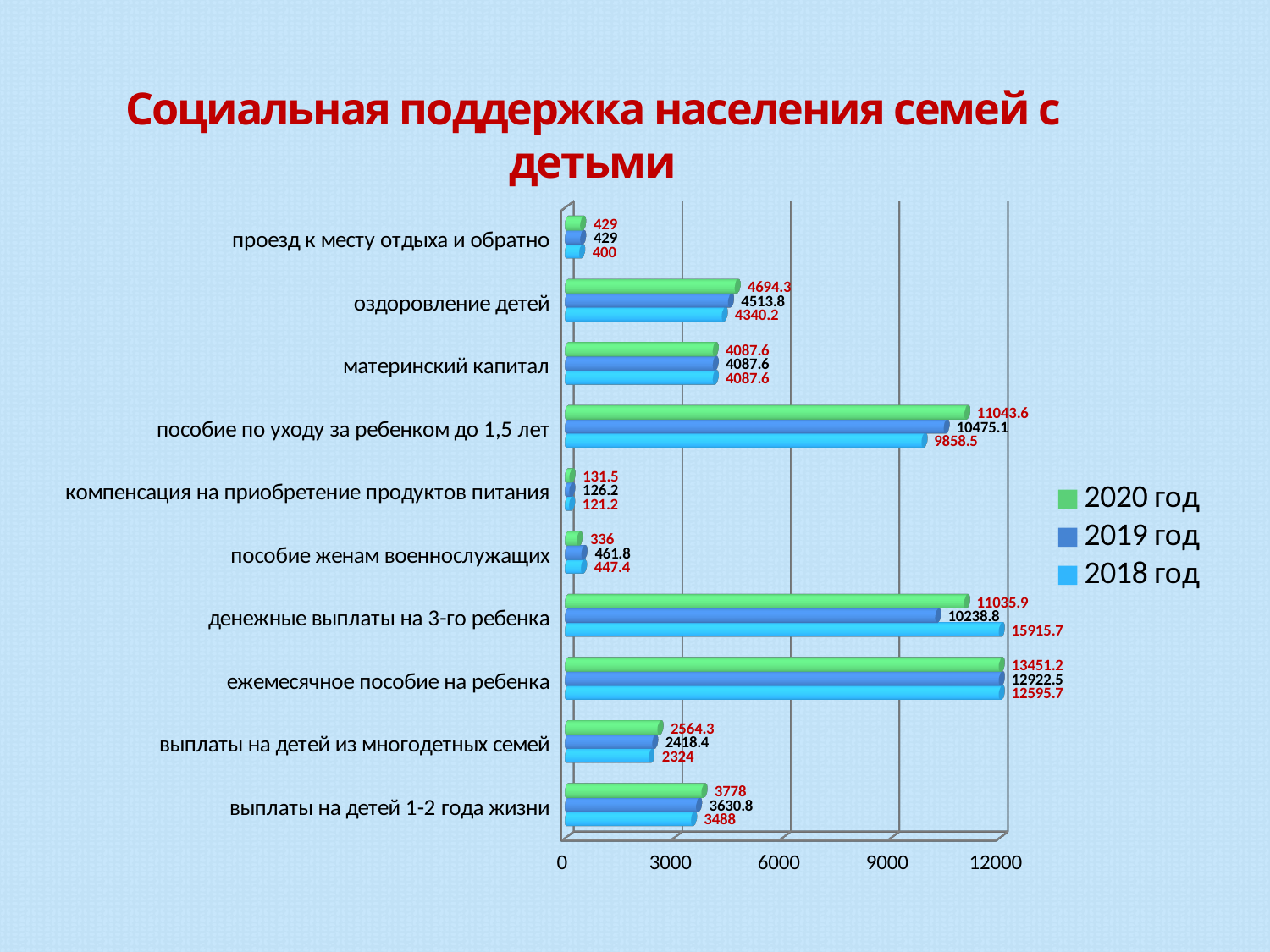
What is the value for оздоровление детей in the 2020 год series? 4694.3 What kind of chart is shown on the slide? bar chart Which category has the highest value in the 2020 год series? ежемесячное пособие на ребенка Which category has the lowest value in the 2019 год series? компенсация на приобретение продуктов питания What is the value for пособие по уходу за ребенком до 1,5 лет in the 2018 год series? 9858.5 What is the difference between the 2020 год and 2018 год values for ежемесячное пособие на ребенка? 855.5 What is the value for денежные выплаты на 3-го ребенка in the 2019 год series? 10238.8 What is the title of the slide? Социальная поддержка населения семей с детьми How many categories are shown on the chart? 10 What is the difference between the 2020 год and 2019 год values for выплаты на детей 1-2 года жизни? 147.2 For пособие женам военнослужащих, which series has the larger value, 2019 год or 2020 год? 2019 год How many series does the legend list? 3